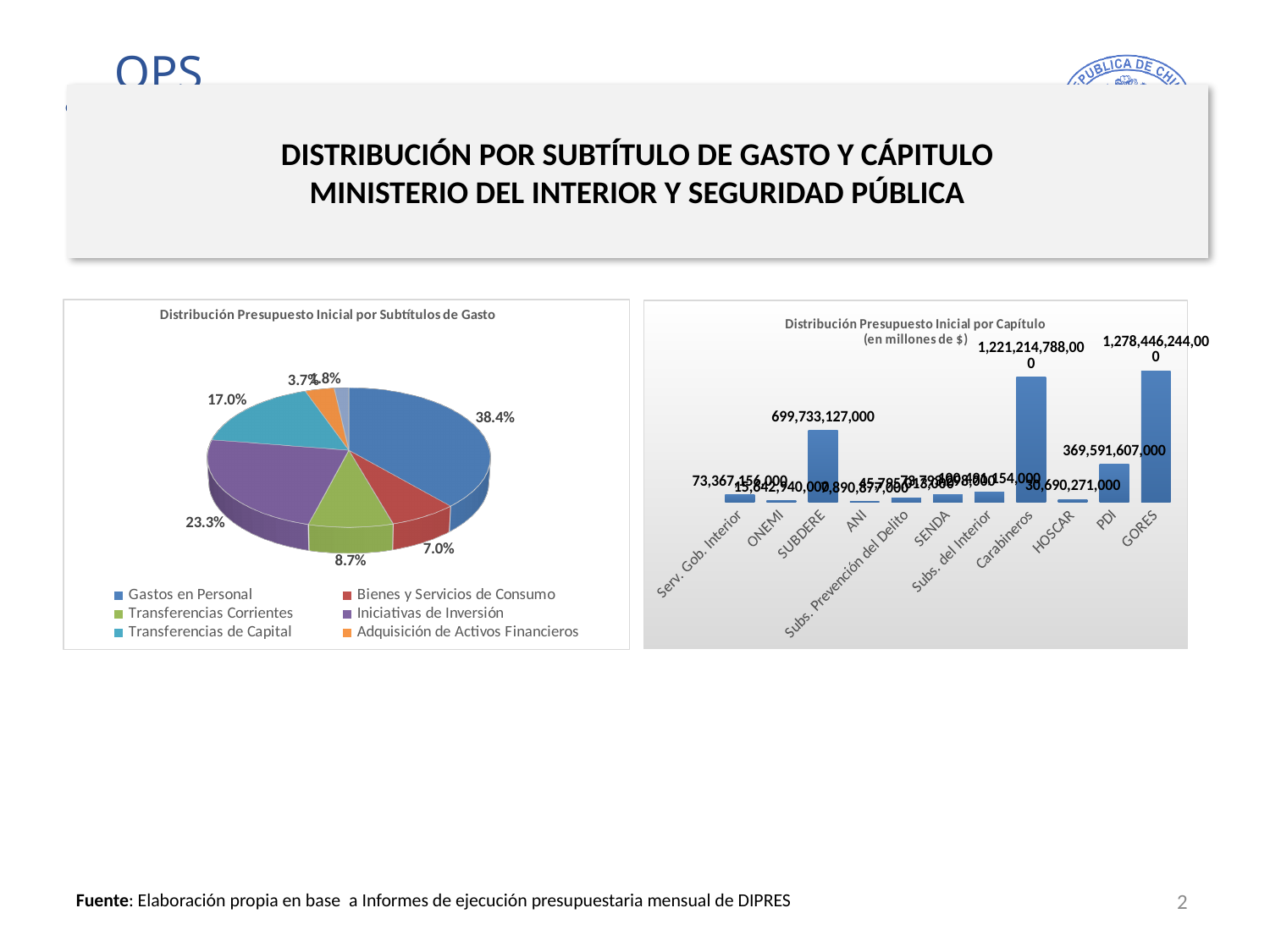
In the pie chart on the left, what share does Gastos en Personal have? 38.4% In the pie chart on the left, which is larger: Transferencias de Capital or Transferencias Corrientes? Transferencias de Capital In the pie chart on the left, which category has the largest share? Gastos en Personal In the bar chart on the right, what is the value for GORES? 1,278,446,244,000 In the pie chart on the left, how many entries does the legend list? 6 In the bar chart on the right, how many capítulos are shown on the x axis? 11 In the bar chart on the right, what is the difference between the values for GORES and Carabineros? 57,231,456,000 What kind of chart is the left chart, 'Distribución Presupuesto Inicial por Subtítulos de Gasto'? Pie chart In the pie chart on the left, what share does Iniciativas de Inversión have? 23.3% In the bar chart on the right, what is the value for SUBDERE? 699,733,127,000 In the bar chart on the right, which capítulo has the highest value? GORES What kind of chart is the right chart, 'Distribución Presupuesto Inicial por Capítulo'? Bar chart